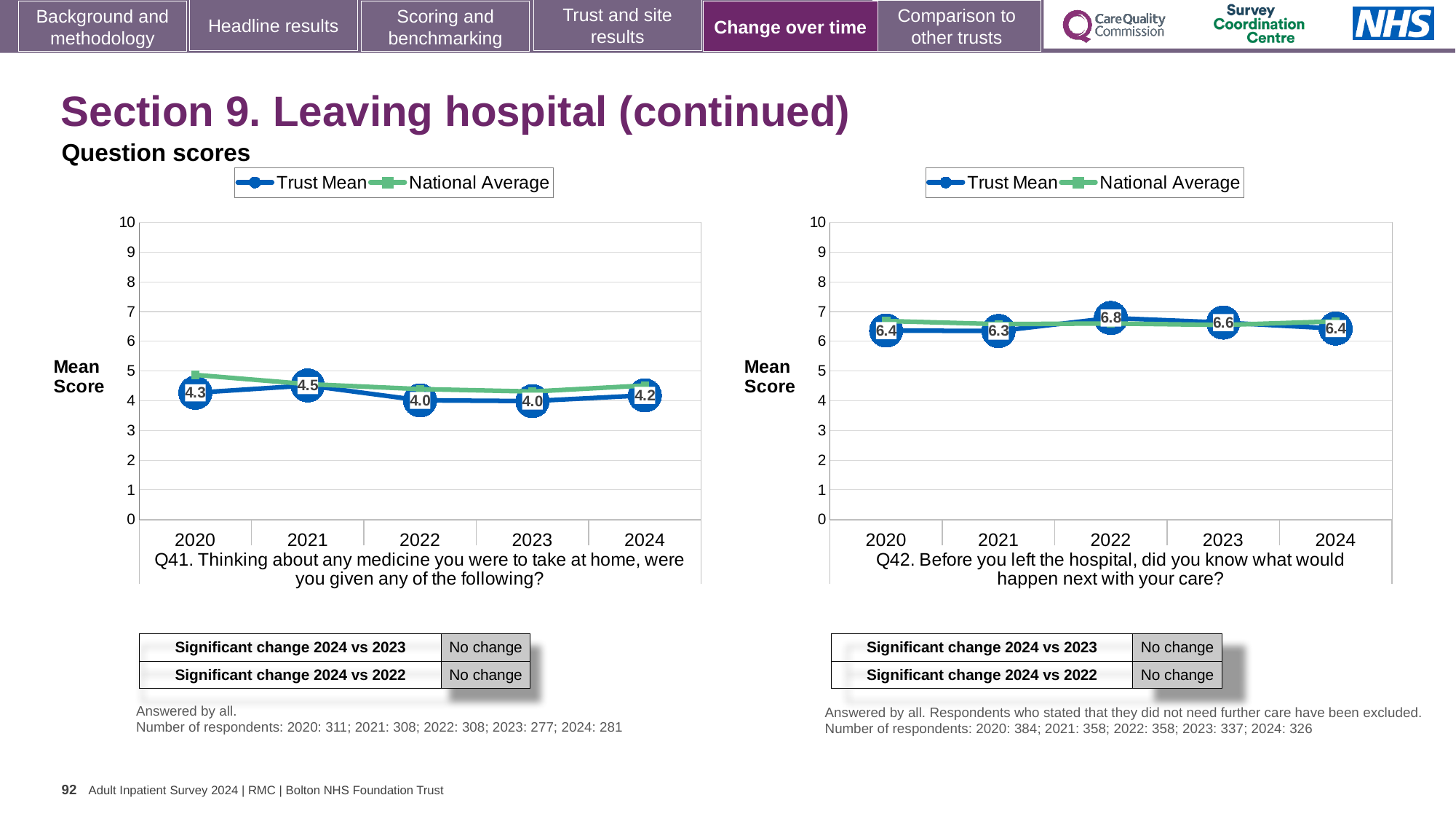
In the Q41 chart on the left, how many years are shown on the x axis? 5 In the Q42 chart on the right, is the National Average value for 2020 greater or less than 6? greater In the Q41 chart on the left, which year has the highest Trust Mean score? 2021 In the Q42 chart on the right, does the Trust Mean score rise or fall from 2022 to 2024? Fall In the Q42 chart on the right, is the Trust Mean score higher in 2022 or in 2023? 2022 What type of chart is the Q41 chart on the left? Line chart In the Q41 chart on the left, what is the difference between the Trust Mean scores for 2021 and 2022? 0.5 In the Q42 chart on the right, what is the difference between the Trust Mean scores for 2022 and 2024? 0.4 In the Q42 chart on the right, what is the Trust Mean score for 2022? 6.8 In the Q42 chart on the right, which year has the lowest Trust Mean score? 2021 In the Q41 chart on the left, what is the Trust Mean score for 2021? 4.5 How many series does the legend of the Q42 chart on the right list? 2